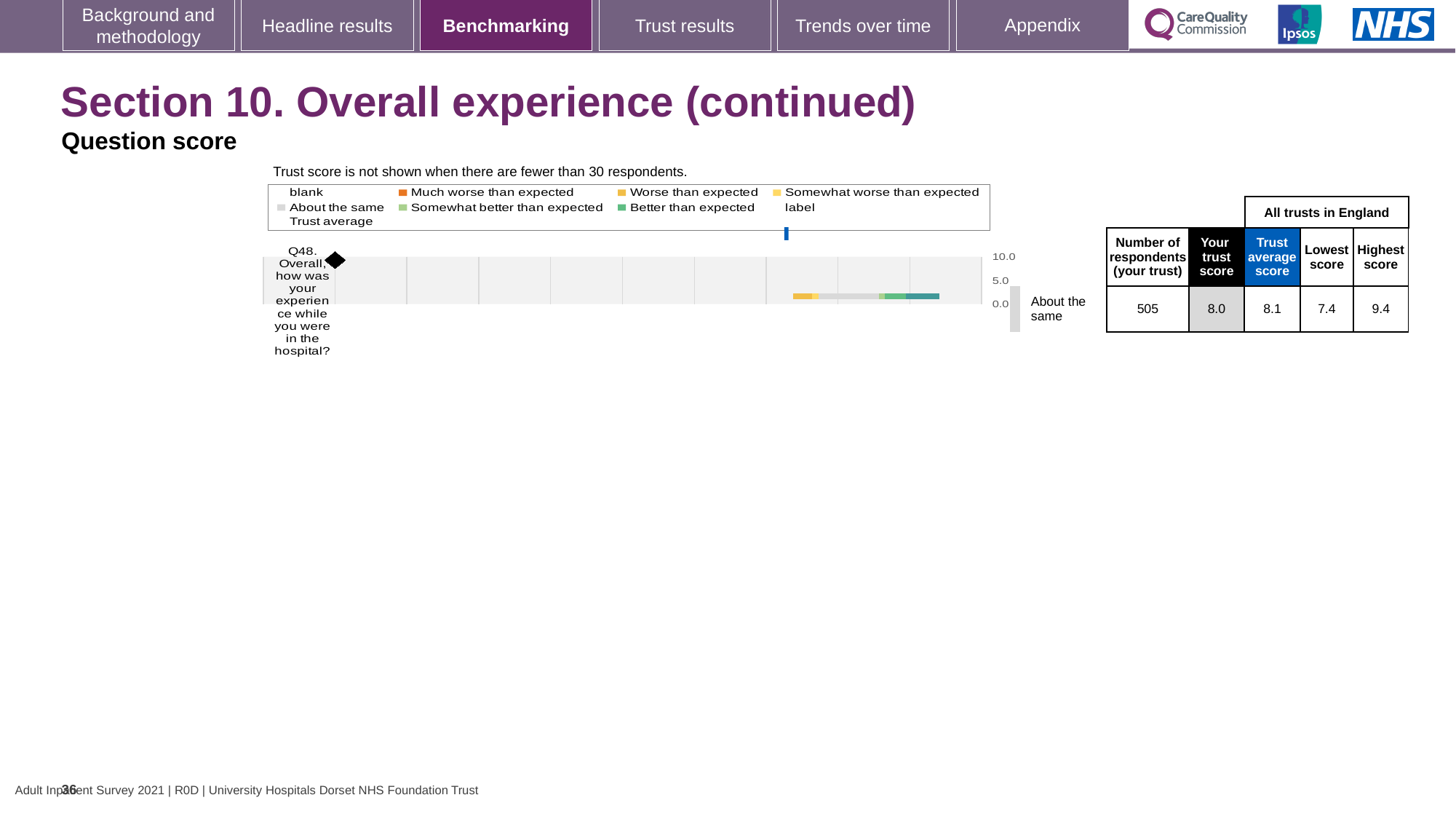
Which is larger for Q48: your trust score or the trust average score? Trust average score What benchmark category is shown next to the Q48 bar? About the same What is the trust average score for Q48 across all trusts in England? 8.1 What is your trust score for Q48? 8.0 What is the highest score for Q48 among all trusts in England? 9.4 What kind of chart is used to show the Q48 benchmarking result? bar chart What is the highest value shown on the chart's score axis? 10.0 What is the number of respondents (your trust) for Q48? 505 What is the lowest score for Q48 among all trusts in England? 7.4 How many survey questions are plotted in the benchmarking chart? 1 What is the difference between the highest score and the lowest score for Q48? 2.0 What is the difference between the trust average score and your trust score for Q48? 0.1